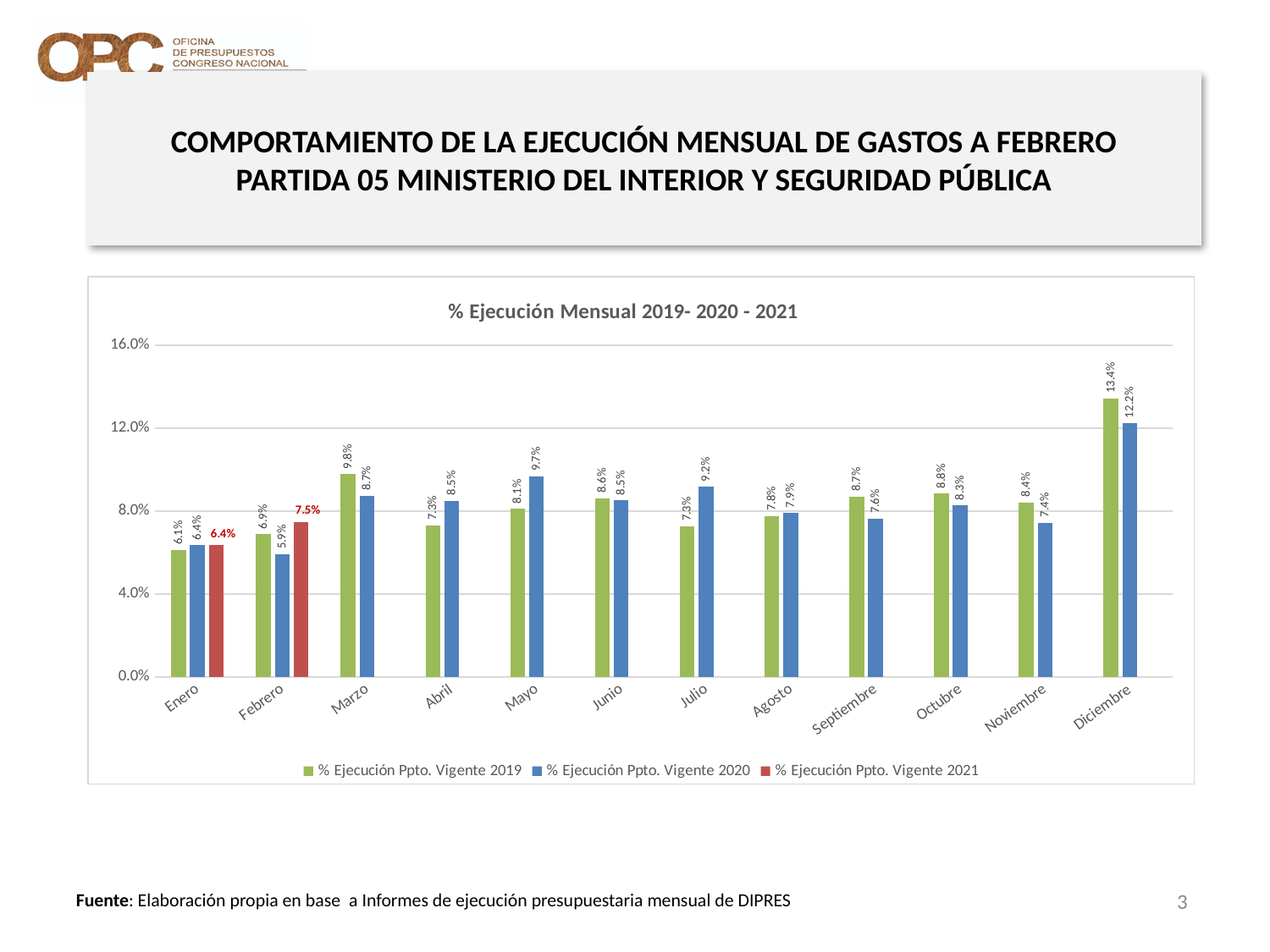
Which month has the highest value for % Ejecución Ppto. Vigente 2020? Diciembre Which is larger for Julio: the 2019 value or the 2020 value? 2020 How many series does the legend list? 3 What is the value of % Ejecución Ppto. Vigente 2020 for Mayo? 9.7% What is the value of % Ejecución Ppto. Vigente 2019 for Diciembre? 13.4% Which month has the lowest value for % Ejecución Ppto. Vigente 2019? Enero What is the value of % Ejecución Ppto. Vigente 2021 for Febrero? 7.5% What is the difference between the 2019 and 2020 values for Marzo? 1.1% How many months are shown on the x axis? 12 What is the title of the chart? % Ejecución Mensual 2019- 2020 - 2021 Is the value of % Ejecución Ppto. Vigente 2020 for Diciembre greater or less than 12.0%? greater What type of chart is shown on the slide? bar chart